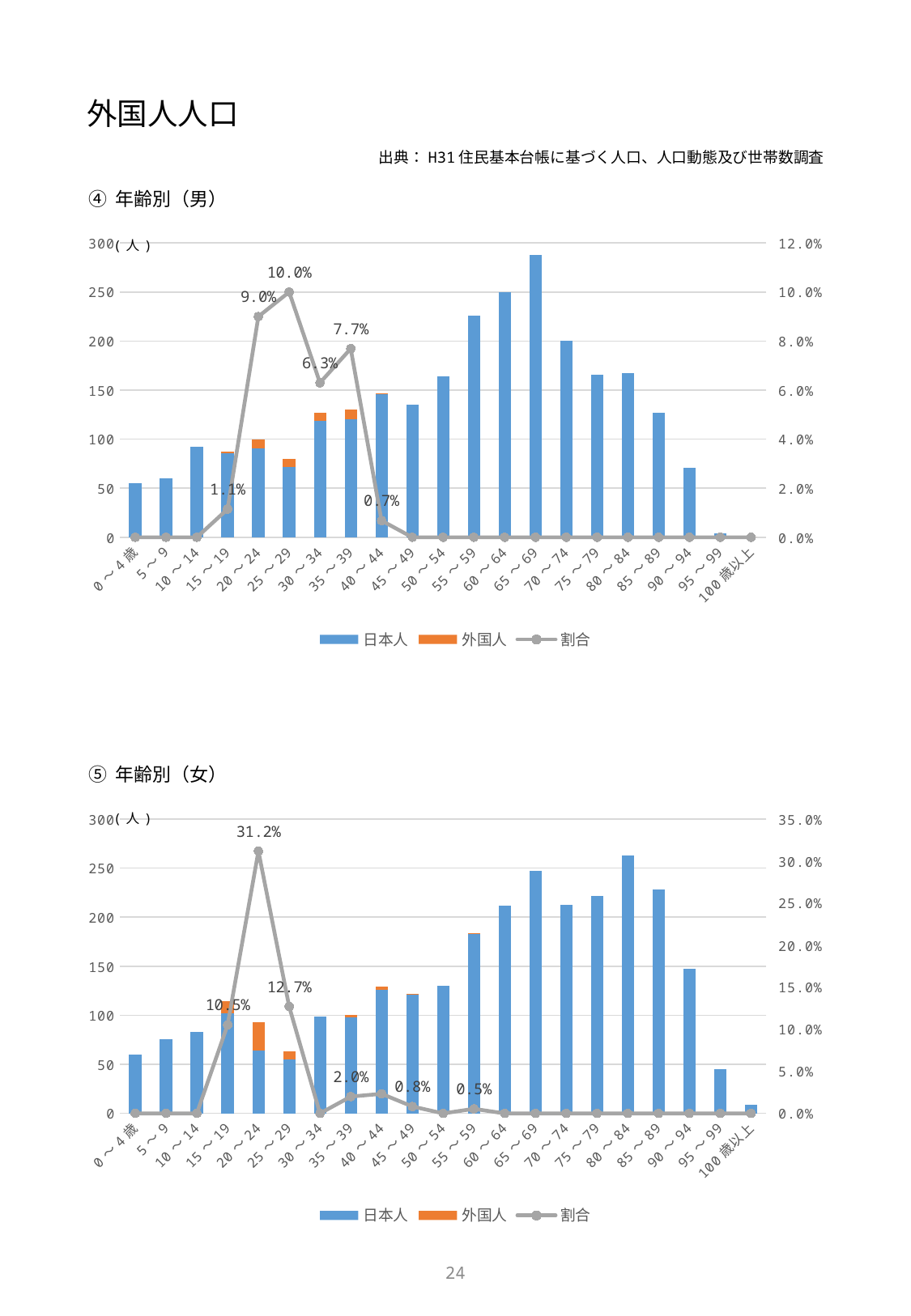
In the ④ 年齢別（男） chart, what is the 割合 value for the 20～24 age group? 9.0% In the ④ 年齢別（男） chart, what is the 割合 value for the 25～29 age group? 10.0% How many series does the legend of the ⑤ 年齢別（女） chart list? 3 How many age-group categories are shown on the x axis of the ④ 年齢別（男） chart? 21 In the ⑤ 年齢別（女） chart, what is the 割合 value for the 20～24 age group? 31.2% In the ⑤ 年齢別（女） chart, what is the 割合 value for the 25～29 age group? 12.7% In the ⑤ 年齢別（女） chart, is the bar for 95～99 greater or less than 50? less In the ④ 年齢別（男） chart, which age group has the tallest bar? 65～69 In the ④ 年齢別（男） chart, what is the difference between the 割合 values for 25～29 and 20～24? 1.0% In the ④ 年齢別（男） chart, is the bar for 65～69 greater or less than 250? greater In the ④ 年齢別（男） chart, what is the 割合 value for the 40～44 age group? 0.7% In the ⑤ 年齢別（女） chart, which age group has the highest 割合 value? 20～24